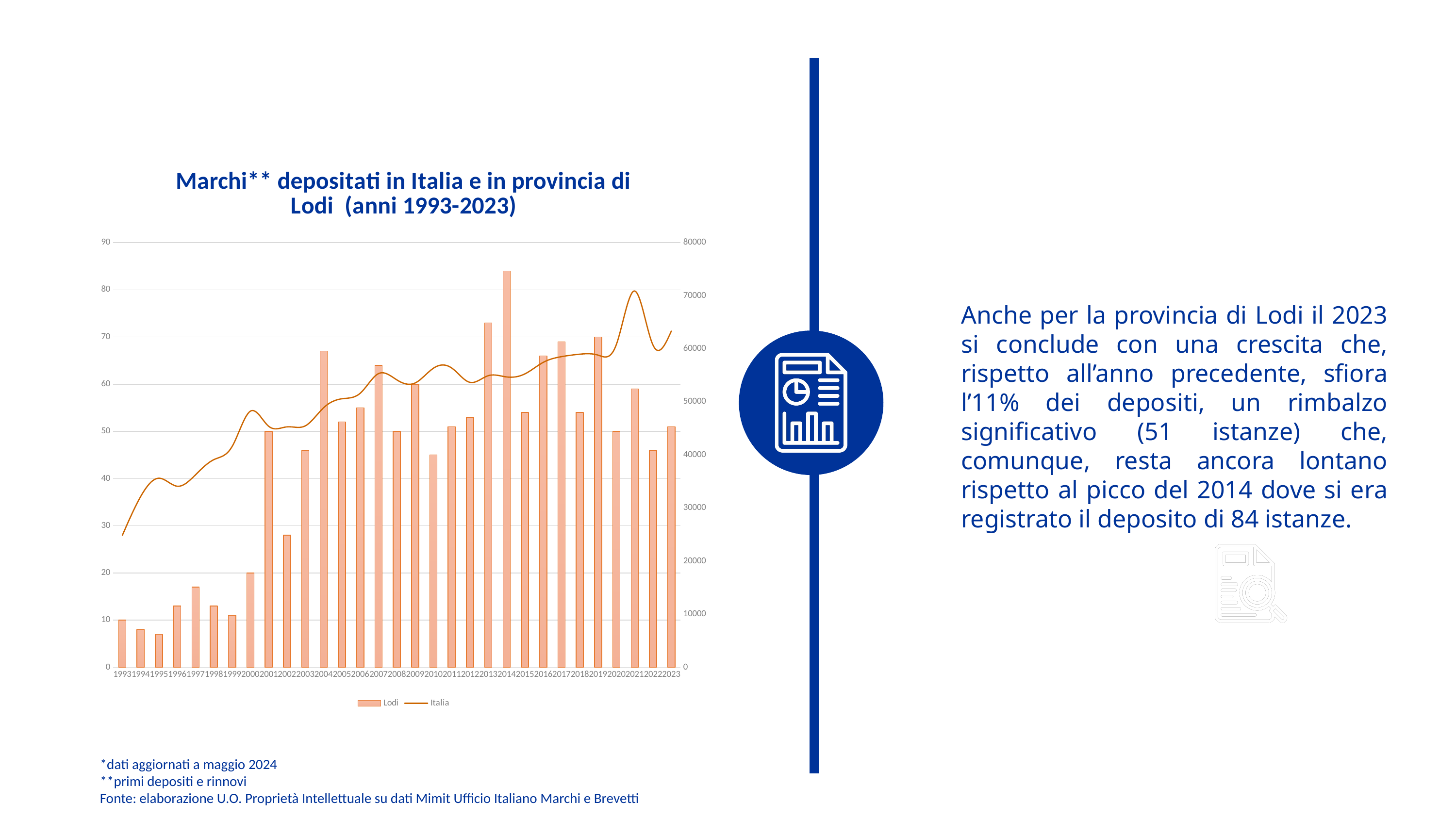
Is the Italia value for 1993 greater or less than 30000? less Is the Lodi value for 2004 greater or less than 60? greater What is the Lodi value for 2023? 51 What kind of chart is shown on the slide? Combined bar and line chart Which is larger, the Lodi value for 2021 or the Lodi value for 2022? 2021 Is the Lodi value for 1995 greater or less than 10? less What is the Lodi value for 2014? 84 What is the title of the chart? Marchi** depositati in Italia e in provincia di Lodi (anni 1993-2023) In which year is the Lodi bar highest? 2014 How many years are shown on the x axis of the chart? 31 What is the difference between the Lodi value for 2014 and the Lodi value for 2023? 33 How many series does the chart legend list? 2